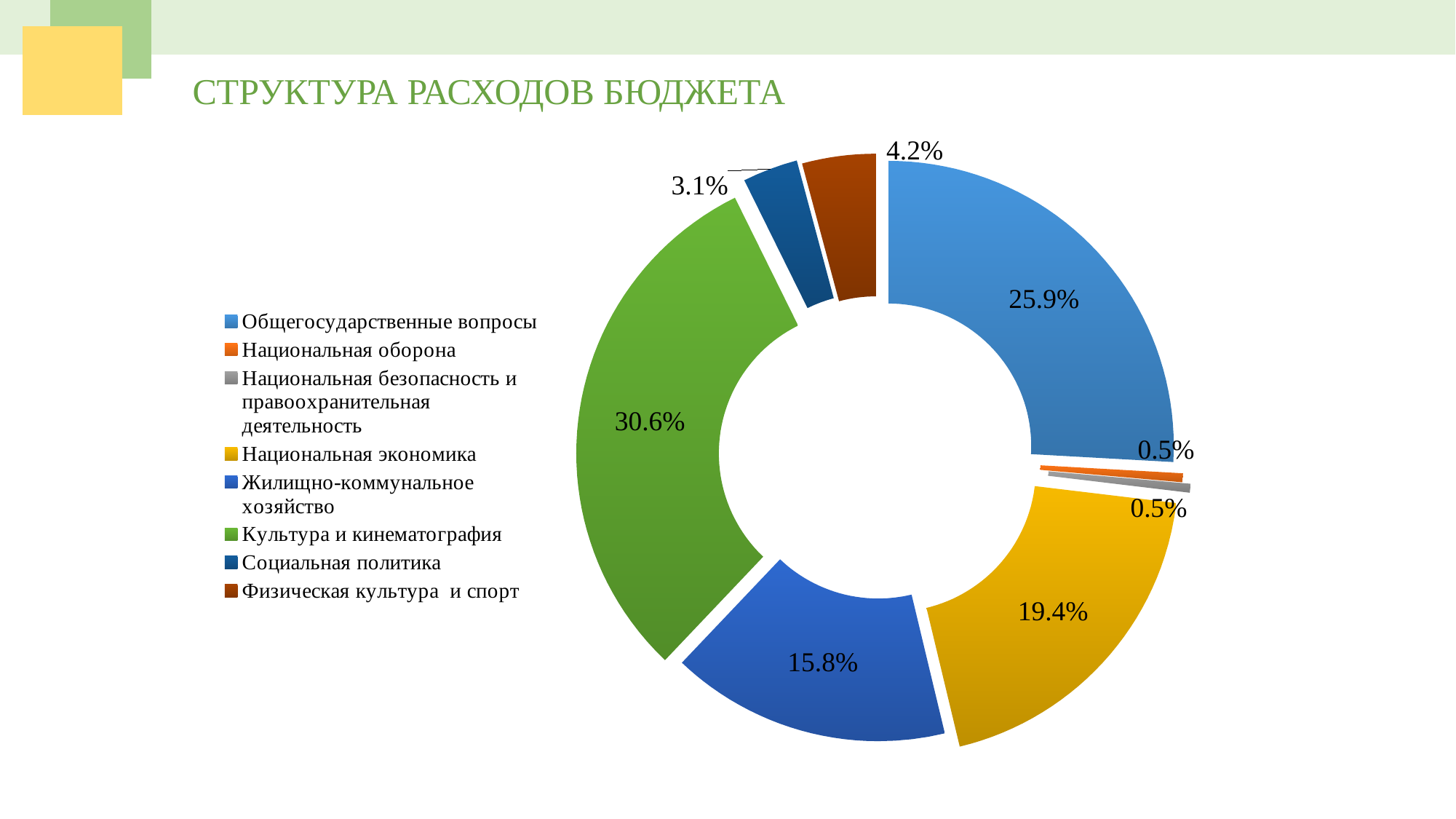
What kind of chart is shown on the slide? Doughnut (pie) chart What is the value for Национальная экономика? 19.4% What share of budget expenditure goes to Культура и кинематография? 30.6% By how many percentage points does the share for Культура и кинематография exceed the share for Общегосударственные вопросы? 4.7 percentage points What is the value for Социальная политика? 3.1% What is the value for Физическая культура и спорт? 4.2% What is the title of the chart? СТРУКТУРА РАСХОДОВ БЮДЖЕТА How many categories does the legend list? 8 Which is larger: the share for Национальная экономика or for Жилищно-коммунальное хозяйство? Национальная экономика What is the value for Жилищно-коммунальное хозяйство? 15.8% What share of budget expenditure goes to Общегосударственные вопросы? 25.9% Which category has the largest share of budget expenditure? Культура и кинематография